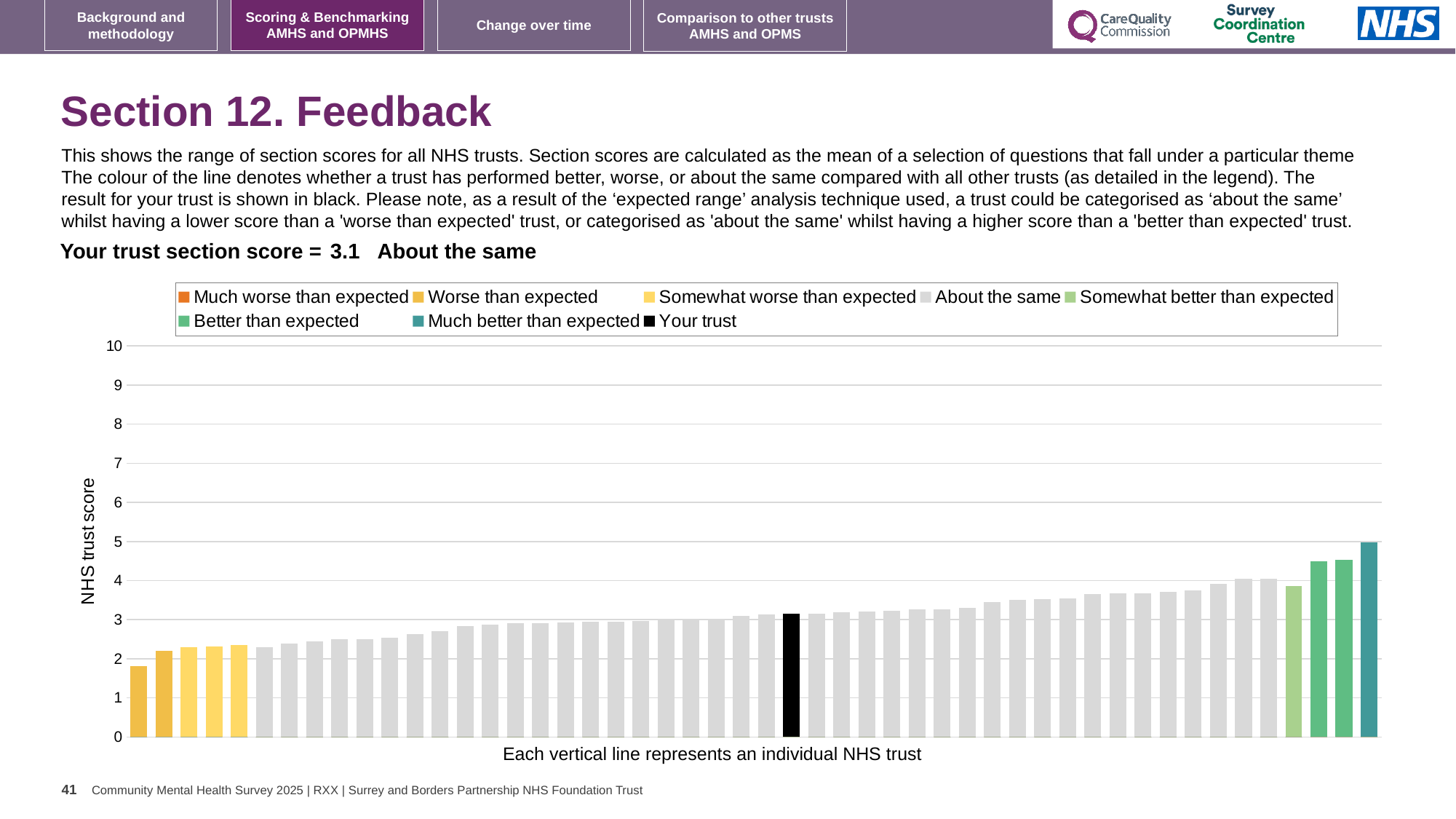
What kind of chart is shown on the slide? bar chart What is the section score for your trust shown on the slide? 3.1 Do the bar values rise or fall from left to right along the x axis? rise Which benchmark category is your trust placed in for Section 12. Feedback? About the same Which legend category does the tallest bar belong to? Much better than expected What colour is the bar representing your trust? black Is the value of the tallest bar (the rightmost, 'Much better than expected' bar) greater or less than 4? greater How many entries does the chart legend list? 8 How many bars are coloured as 'Better than expected'? 2 Is the value of the black 'Your trust' bar greater or less than 4? less What is the label on the y axis of the chart? NHS trust score Is the value of the leftmost bar greater or less than 3? less